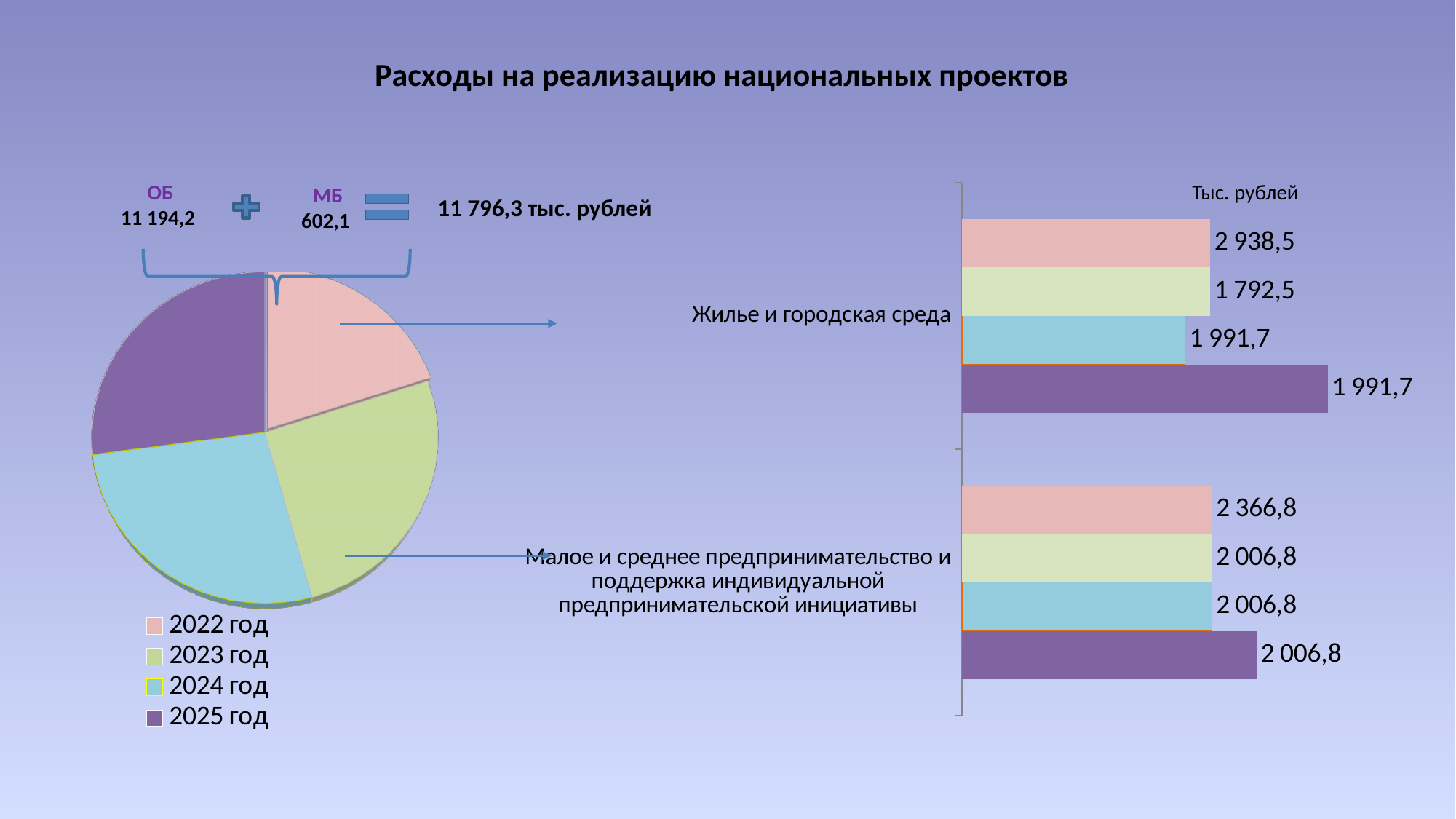
In the bar chart, what is the value of the 2022 год bar for Малое и среднее предпринимательство и поддержка индивидуальной предпринимательской инициативы? 2 366,8 In the bar chart, what is the value of the 2023 год bar for Жилье и городская среда? 1 792,5 In the pie chart, which year has the smallest slice? 2022 год What kind of chart is on the left side of the slide? pie chart In the bar chart, what is the value of the 2022 год bar for Жилье и городская среда? 2 938,5 What kind of chart is on the right side of the slide? bar chart In the bar chart, which is larger for 2022 год: Жилье и городская среда or Малое и среднее предпринимательство? Жилье и городская среда How many entries does the legend of the pie chart list? 4 In the bar chart, which year has the lowest value for Жилье и городская среда? 2023 год In the bar chart, which year has the highest value for Жилье и городская среда? 2022 год In the bar chart, what is the difference between the 2022 год and 2023 год values for Жилье и городская среда? 1 146,0 In the bar chart, what is the value of the 2025 год bar for Малое и среднее предпринимательство и поддержка индивидуальной предпринимательской инициативы? 2 006,8